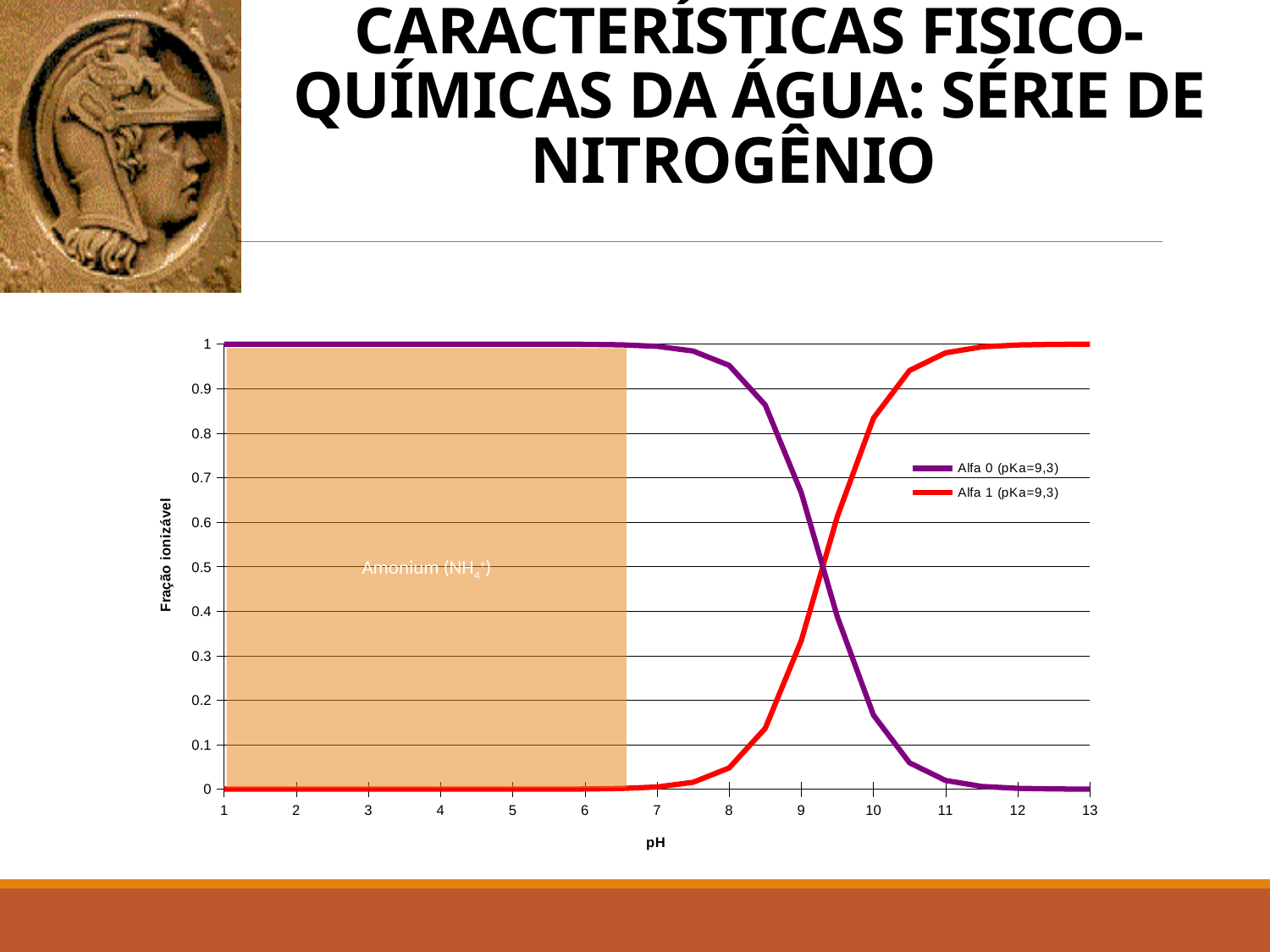
Is the value of Alfa 1 (pKa=9,3) at pH 11 greater or less than 0.9? greater What is the label of the y axis? Fração ionizável Is the value of Alfa 1 (pKa=9,3) at pH 8 greater or less than 0.1? less At pH 8, which series has the higher value, Alfa 0 (pKa=9,3) or Alfa 1 (pKa=9,3)? Alfa 0 (pKa=9,3) Does the Alfa 1 (pKa=9,3) series rise or fall as pH increases? rise How many series does the legend list? 2 What kind of chart is shown on the slide? line chart Is the value of Alfa 0 (pKa=9,3) at pH 10 greater or less than 0.2? less What are the two series named in the legend? Alfa 0 (pKa=9,3) and Alfa 1 (pKa=9,3) Does the Alfa 0 (pKa=9,3) series rise or fall as pH increases? fall At pH 10, which series has the higher value, Alfa 0 (pKa=9,3) or Alfa 1 (pKa=9,3)? Alfa 1 (pKa=9,3)